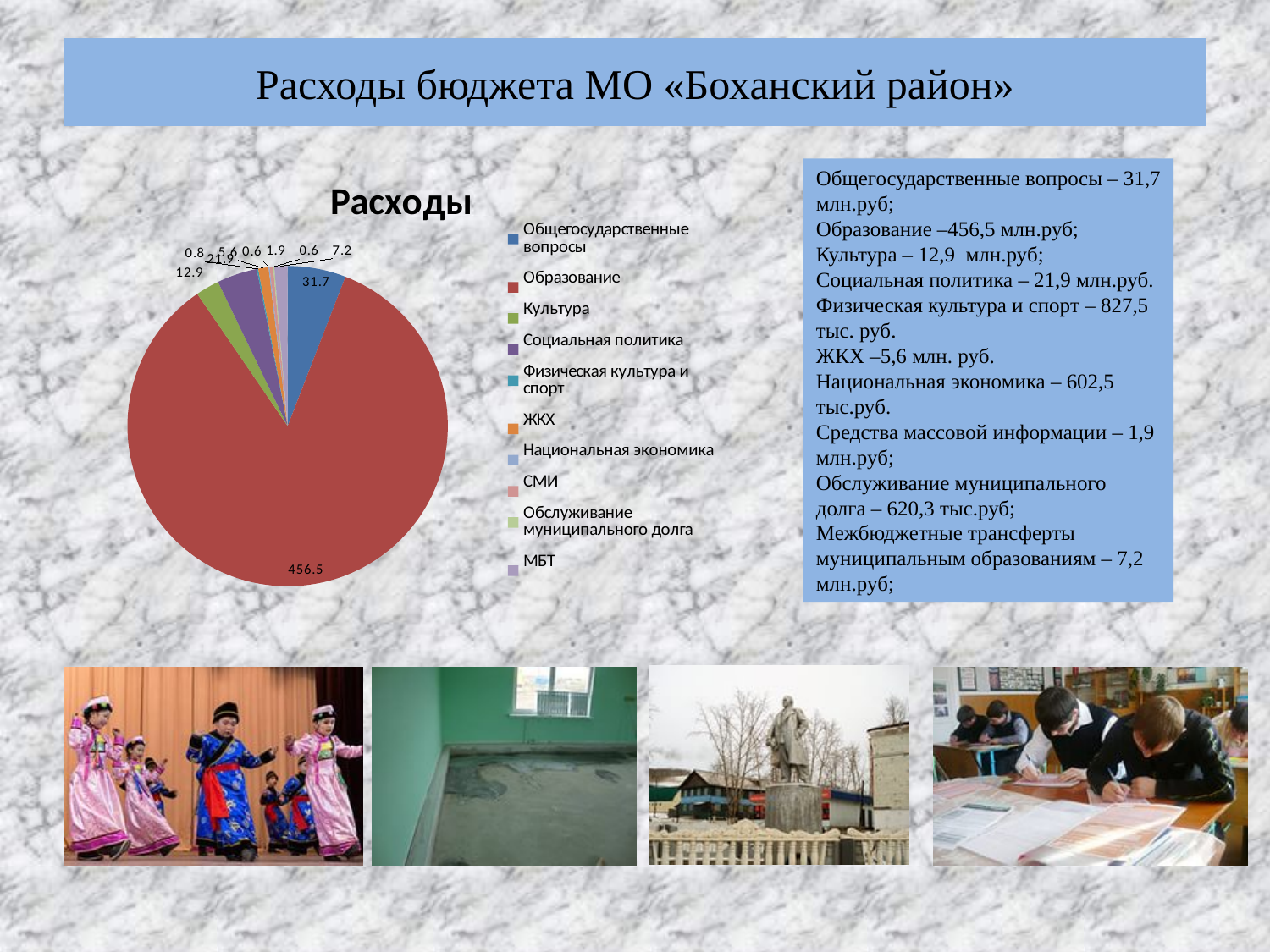
What is the difference between the values for Образование and Общегосударственные вопросы? 424.8 What value is shown for МБТ in the pie chart? 7.2 What value is shown for Образование in the pie chart? 456.5 What value is shown for Общегосударственные вопросы in the pie chart? 31.7 Which category has the largest slice of the pie chart? Образование What is the title of the chart? Расходы What value is shown for ЖКХ in the pie chart? 5.6 What type of chart is shown on the slide? pie chart How many categories does the legend of the pie chart list? 10 Which is larger in the pie chart, Образование or Общегосударственные вопросы? Образование What colour is the slice for Образование in the pie chart? red What value is shown for Культура in the pie chart? 12.9